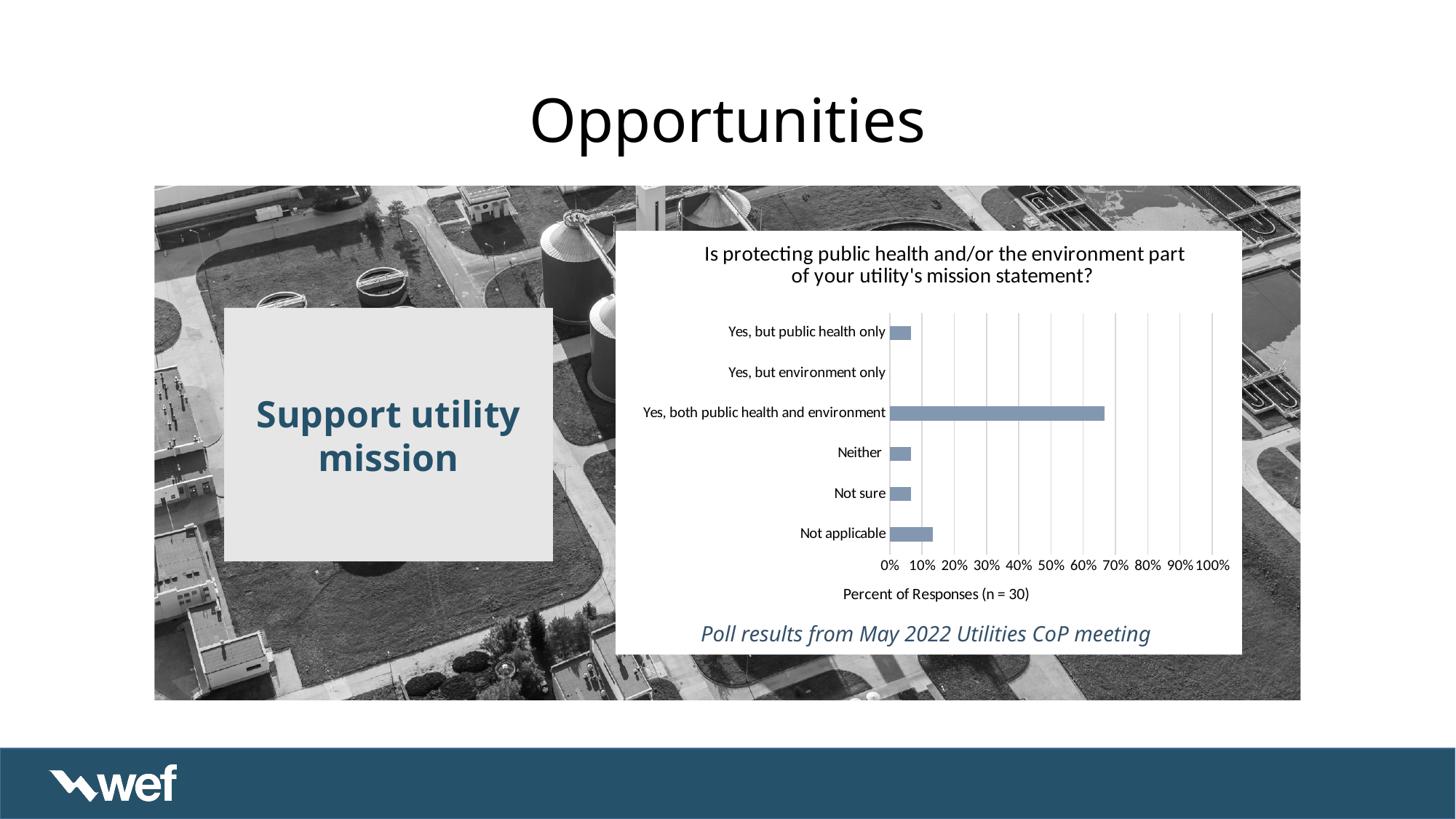
Which response category has the lowest percentage of responses? Yes, but environment only Is the value for 'Neither' greater or less than 10%? less Is the value for 'Not applicable' greater or less than 20%? less What is the label of the horizontal axis of the chart? Percent of Responses (n = 30) What kind of chart is shown on the slide? bar chart Is the value for 'Yes, both public health and environment' greater or less than 70%? less What is the title of the chart? Is protecting public health and/or the environment part of your utility's mission statement? How many response categories are shown on the chart? 6 Which has a larger percentage of responses, 'Not applicable' or 'Not sure'? Not applicable Which response category has the highest percentage of responses? Yes, both public health and environment